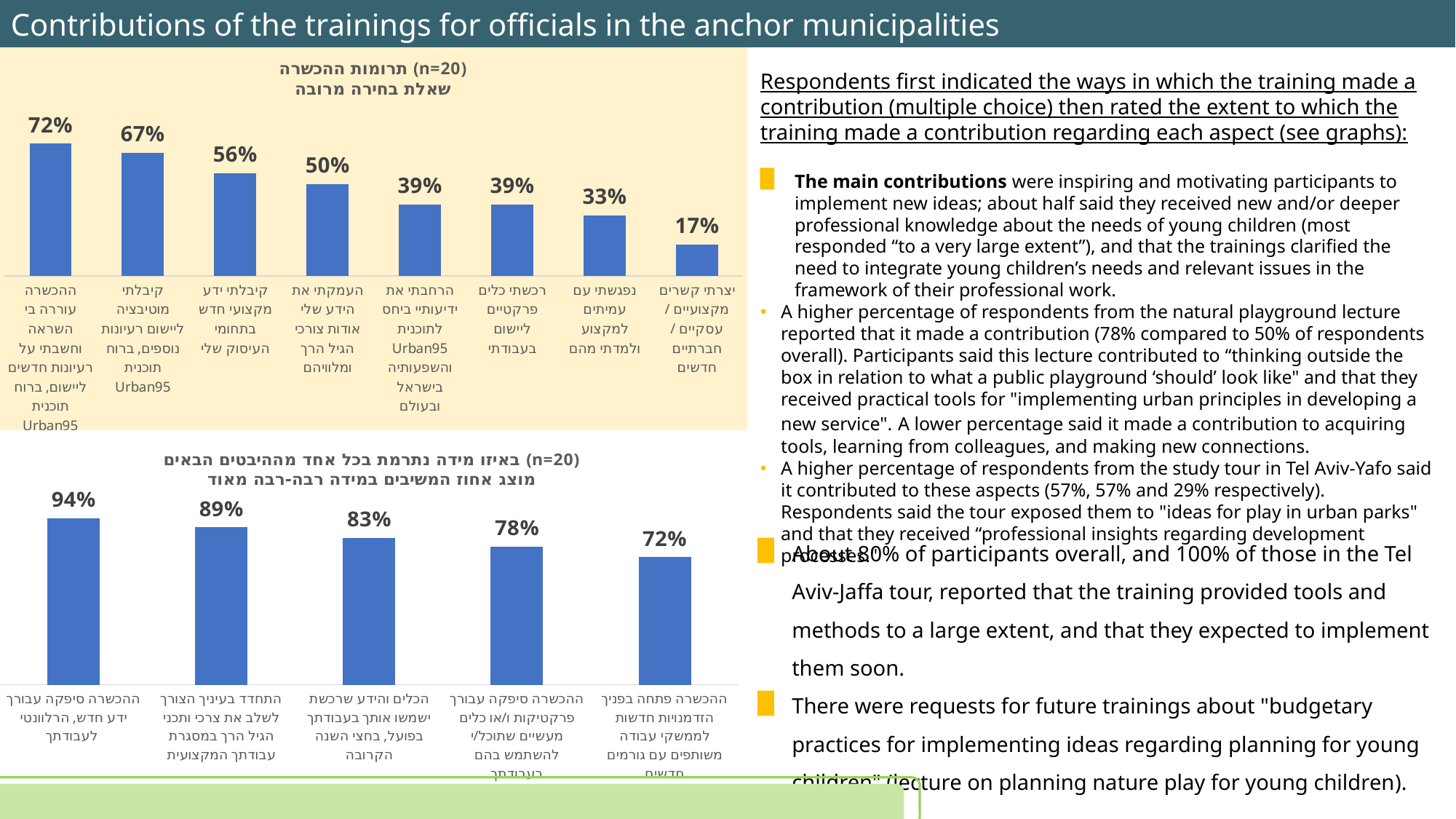
In the top chart, what is the value for the category 'רכשתי כלים פרקטיים ליישום בעבודתי'? 39% In the top chart, what is the difference between the highest value (72%) and the lowest value (17%)? 55% In the bottom chart, how many categories are shown? 5 In the top chart, how many bars are plotted? 8 In the top chart, which category has the highest value? ההכשרה עוררה בי השראה וחשבתי על רעיונות חדשים ליישום, ברוח תוכנית Urban95 In the bottom chart, do the values rise or fall from left to right? fall In the top chart, what is the value for 'נפגשתי עם עמיתים למקצוע ולמדתי מהם'? 33% In the bottom chart, what is the value for 'הכלים והידע שרכשת ישמשו אותך בעבודתך בפועל, בחצי השנה הקרובה'? 83% In the top chart, which category has the lowest value? יצרתי קשרים מקצועיים / עסקיים / חברתיים חדשים What type of chart is the top chart? bar chart In the bottom chart, which category has the highest value? ההכשרה סיפקה עבורך ידע חדש, הרלוונטי לעבודתך In the bottom chart, what is the difference between the first bar (94%) and the last bar (72%)? 22%